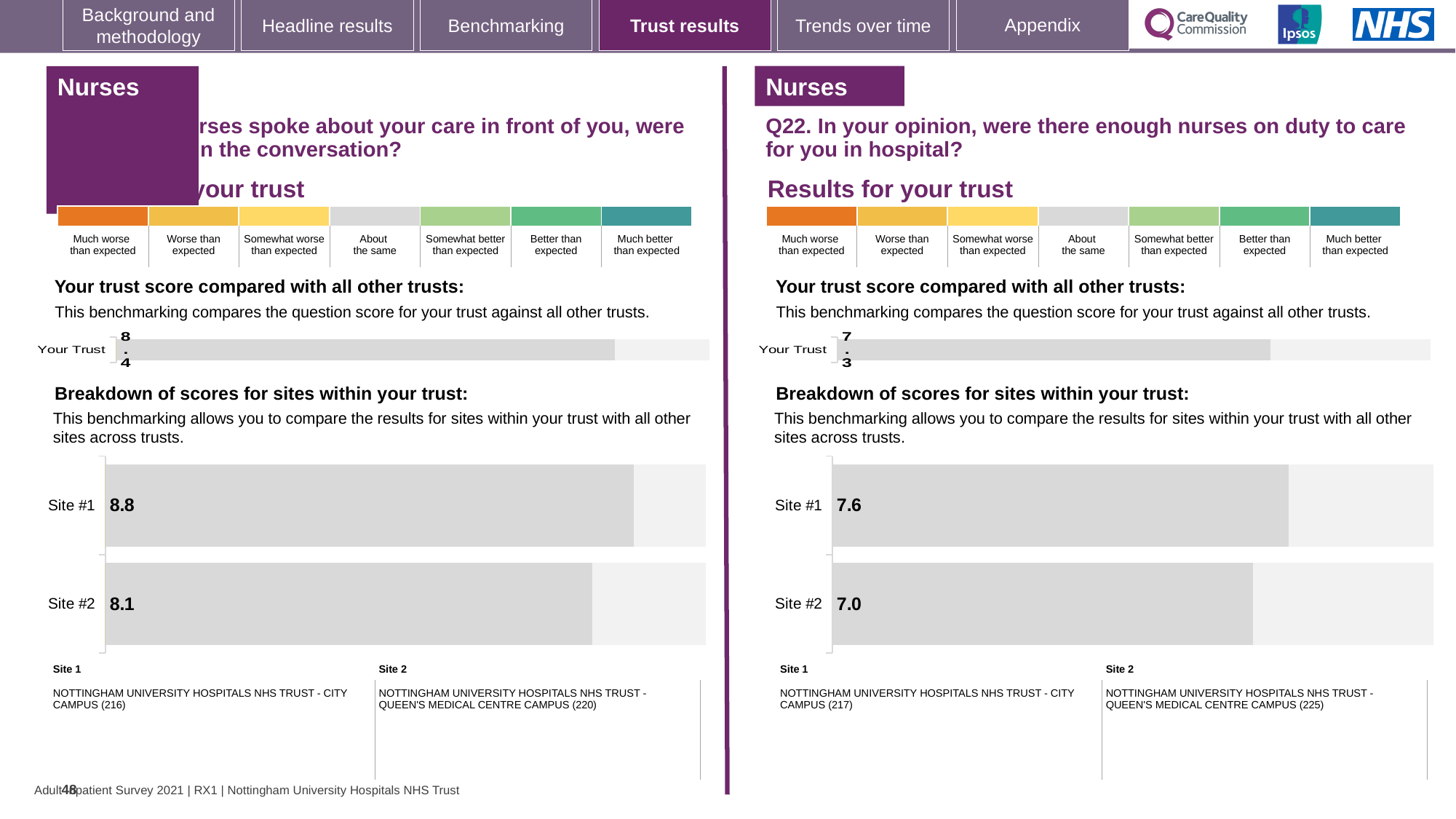
On the right-hand (Q22) site breakdown chart, what is the difference between the Site #1 and Site #2 scores? 0.6 On the right-hand (Q22) site breakdown chart, which site has the lower score? Site #2 On the right-hand (Q22) 'Your Trust' chart, what is the trust score shown? 7.3 On the left-hand 'Your Trust' chart, what is the trust score shown? 8.4 On the left-hand site breakdown chart, what is the difference between the Site #1 and Site #2 scores? 0.7 How many sites are shown on the right-hand (Q22) site breakdown chart? 2 On the left-hand site breakdown chart, what is the score for Site #2? 8.1 On the right-hand (Q22) site breakdown chart, what is the score for Site #1? 7.6 What type of chart is used for the site breakdown on the left-hand side of the slide? Bar chart On the right-hand (Q22) site breakdown chart, what is the score for Site #2? 7.0 On the left-hand site breakdown chart, what is the score for Site #1? 8.8 On the left-hand site breakdown chart, which site has the higher score? Site #1